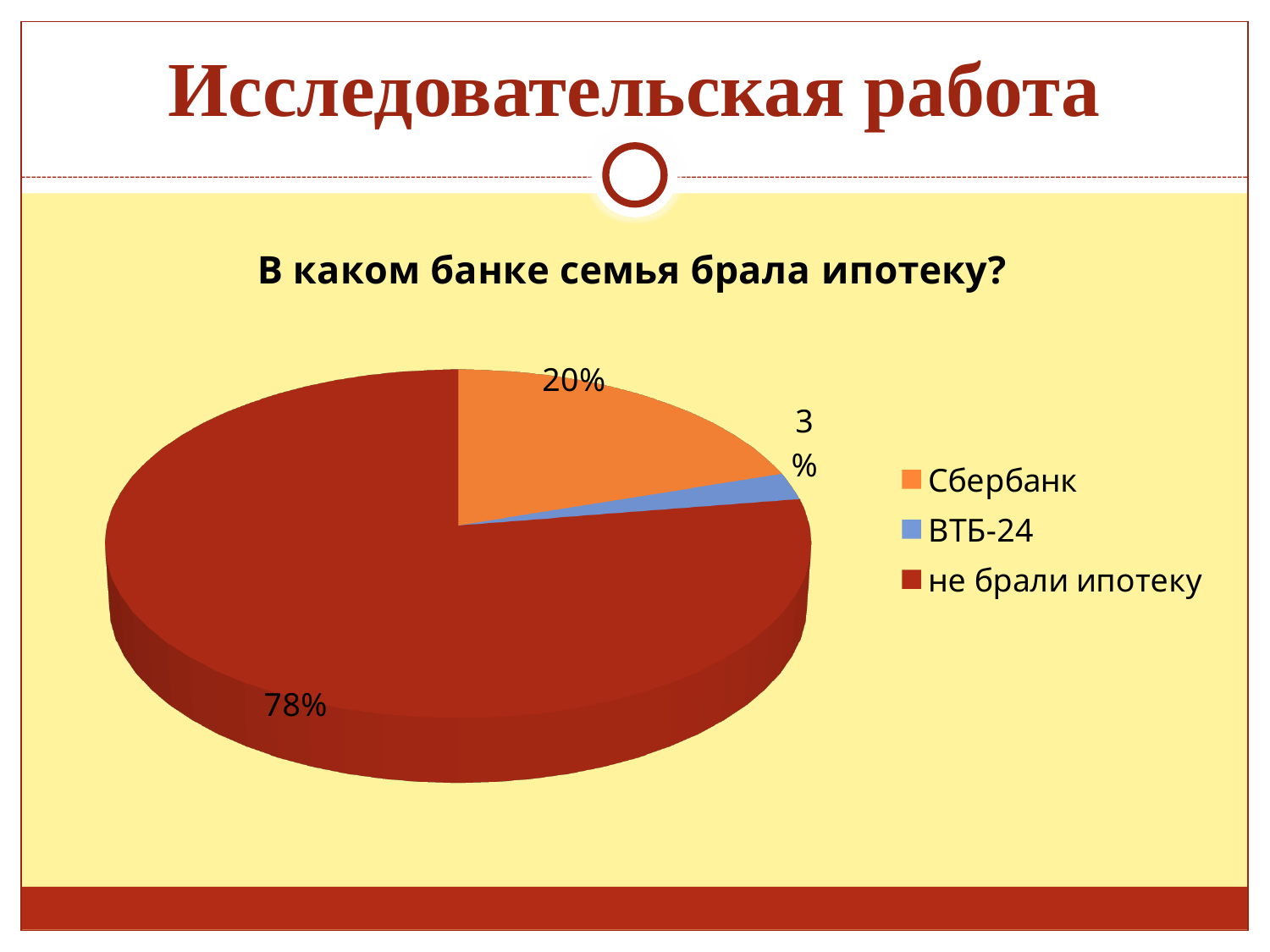
What kind of chart is shown on the slide? pie chart Which colour represents ВТБ-24 in the pie chart? blue Which category has the largest slice of the pie? не брали ипотеку How many entries does the legend list? 3 What share of the pie does Сбербанк have? 20% What share of the pie does ВТБ-24 have? 3% What is the difference in percentage points between the 'не брали ипотеку' slice and the Сбербанк slice? 58 What share of the pie does 'не брали ипотеку' have? 78% Which category has the smallest slice of the pie? ВТБ-24 How many slices does the pie chart have? 3 What is the title of the chart? В каком банке семья брала ипотеку? Which slice is larger, Сбербанк or ВТБ-24? Сбербанк